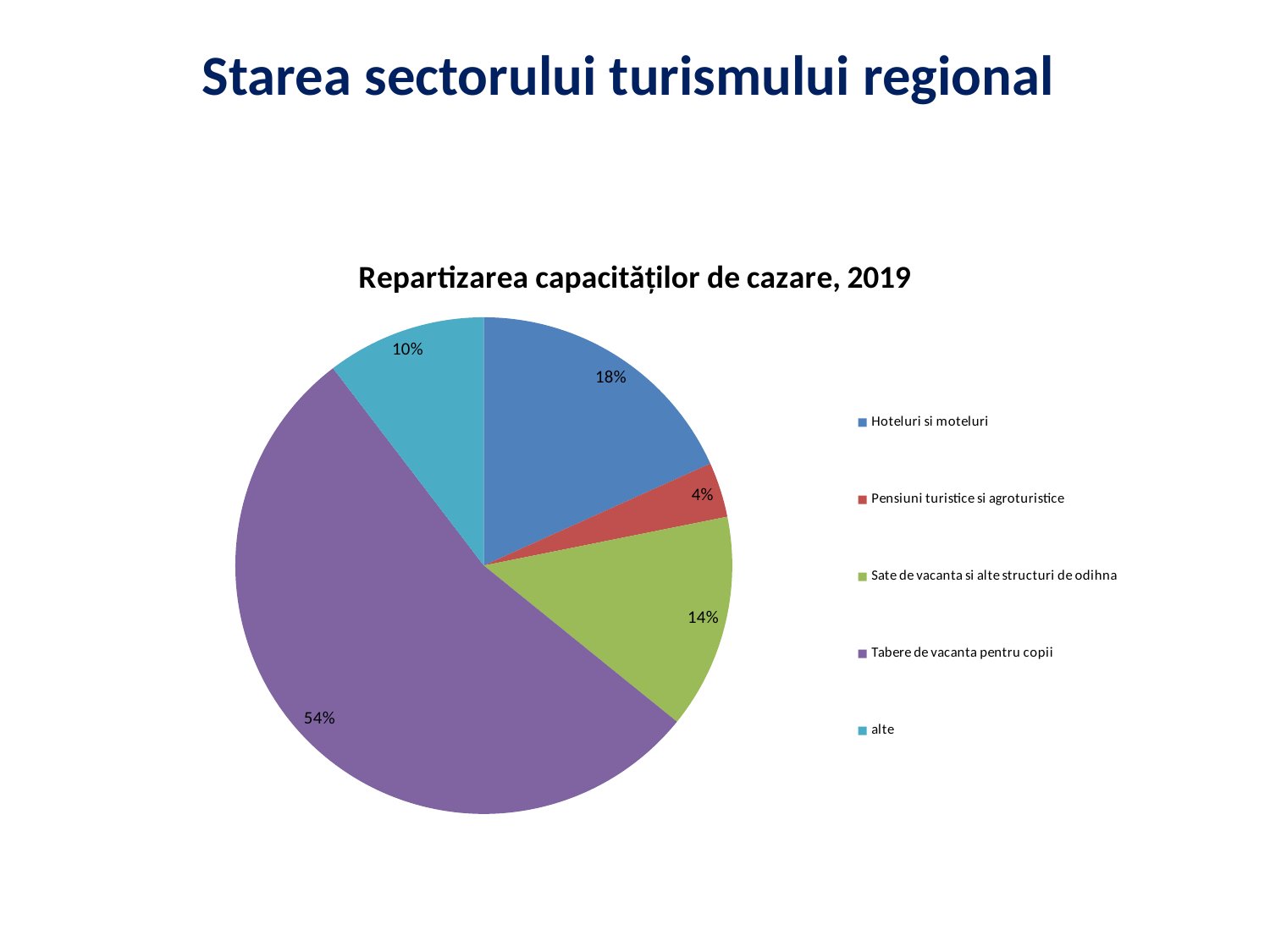
What is the value for Pensiuni turistice si agroturistice? 4% What is the chart's title? Repartizarea capacităților de cazare, 2019 Which is larger, Sate de vacanta si alte structuri de odihna or Hoteluri si moteluri? Hoteluri si moteluri What is the value for Hoteluri si moteluri? 18% Which category has the smallest slice? Pensiuni turistice si agroturistice What is the difference between the shares of Hoteluri si moteluri and alte? 8% How many categories does the pie chart have? 5 What share of the pie does Tabere de vacanta pentru copii have? 54% Which category has the largest slice? Tabere de vacanta pentru copii What kind of chart is shown on the slide? pie chart What is the value for alte? 10% What is the value for Sate de vacanta si alte structuri de odihna? 14%